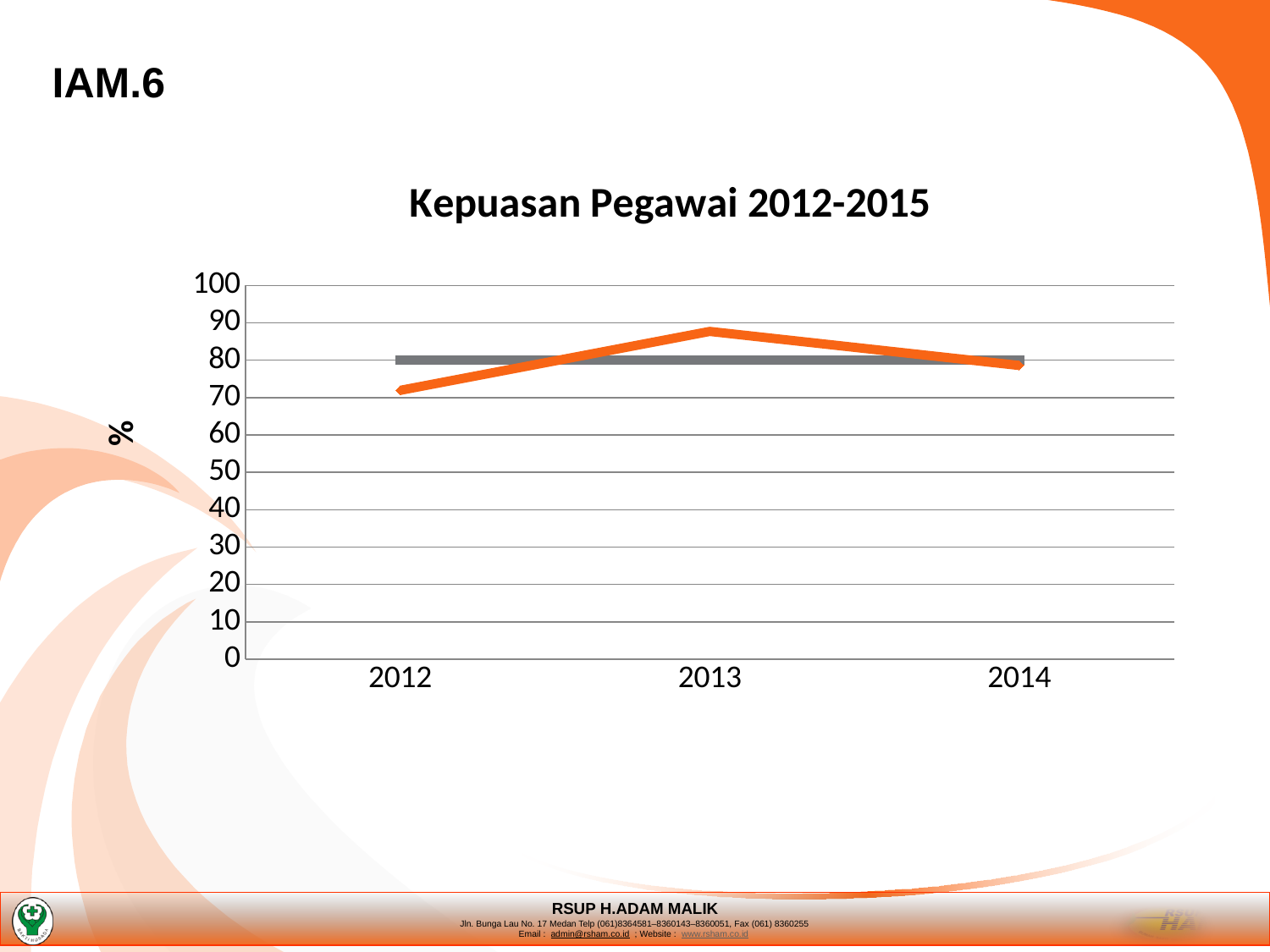
Is the value of the orange line for 2012 greater or less than 80? less How many years are shown on the x axis of the chart? 3 What is the title of the chart? Kepuasan Pegawai 2012-2015 Is the value of the orange line for 2013 greater or less than 80? greater Does the orange line rise or fall from 2013 to 2014? fall What kind of chart is shown on the slide? line chart Does the orange line rise or fall from 2012 to 2013? rise What label is shown on the y axis of the chart? % In which year does the orange line have its lowest value? 2012 In which year does the orange line reach its highest value? 2013 Which year has a higher value on the orange line, 2012 or 2013? 2013 Is the value of the orange line for 2013 greater or less than 90? less